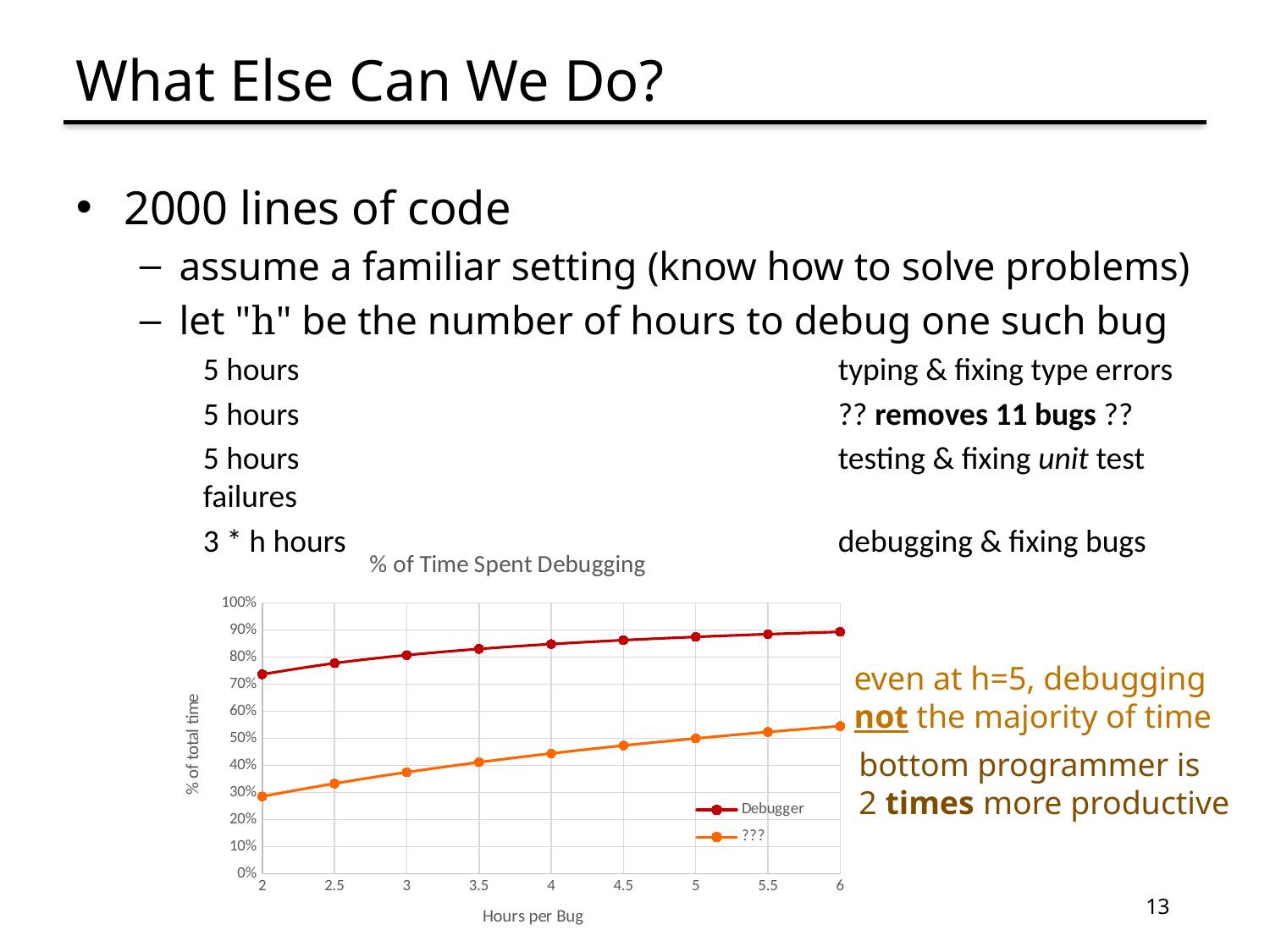
Is the value for the Debugger series at 4 hours per bug greater or less than 80%? greater How many series does the chart's legend list? 2 Do the values of the ??? series rise or fall as hours per bug increases? rise What are the two series named in the legend? Debugger and ??? What is the title of the chart? % of Time Spent Debugging Is the value for the Debugger series at 2 hours per bug greater or less than 70%? greater How many data points are plotted for the Debugger series? 9 What is the label of the x axis? Hours per Bug Is the value for the ??? series at 4 hours per bug greater or less than 50%? less What type of chart is shown on the slide? line chart Which series has the higher value at 5 hours per bug, Debugger or ??? Debugger